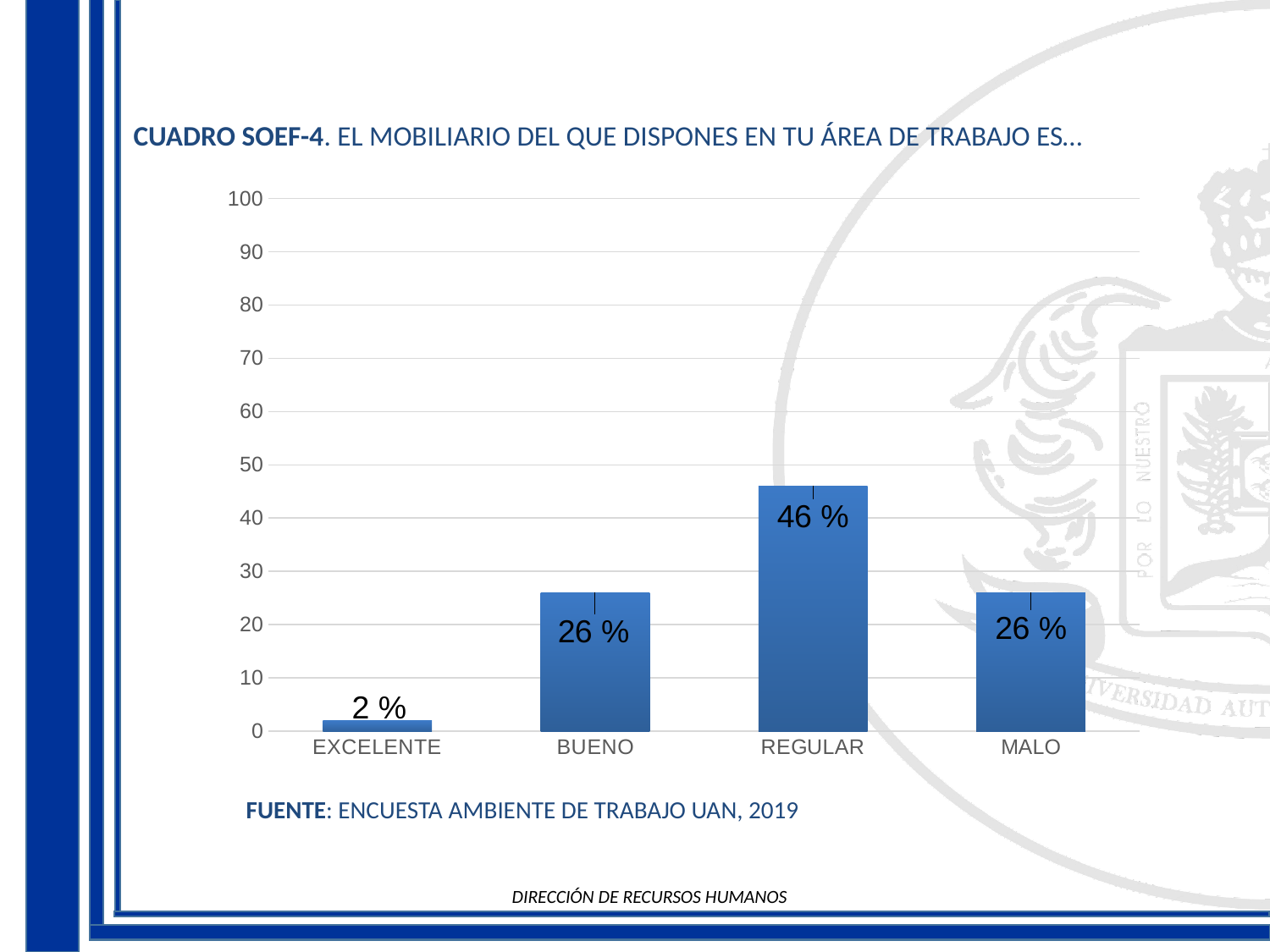
What is the value for REGULAR? 46 % How many categories are shown on the x axis? 4 Is the value for REGULAR greater or less than 50? less What is the difference between the values for REGULAR and BUENO? 20 % What is the value for MALO? 26 % Which category has the lowest value? EXCELENTE What is the value for EXCELENTE? 2 % What is the difference between the values for MALO and EXCELENTE? 24 % What kind of chart is shown on the slide? bar chart What is the value for BUENO? 26 % Which category has the highest value? REGULAR Which is larger, the value for REGULAR or the value for MALO? REGULAR